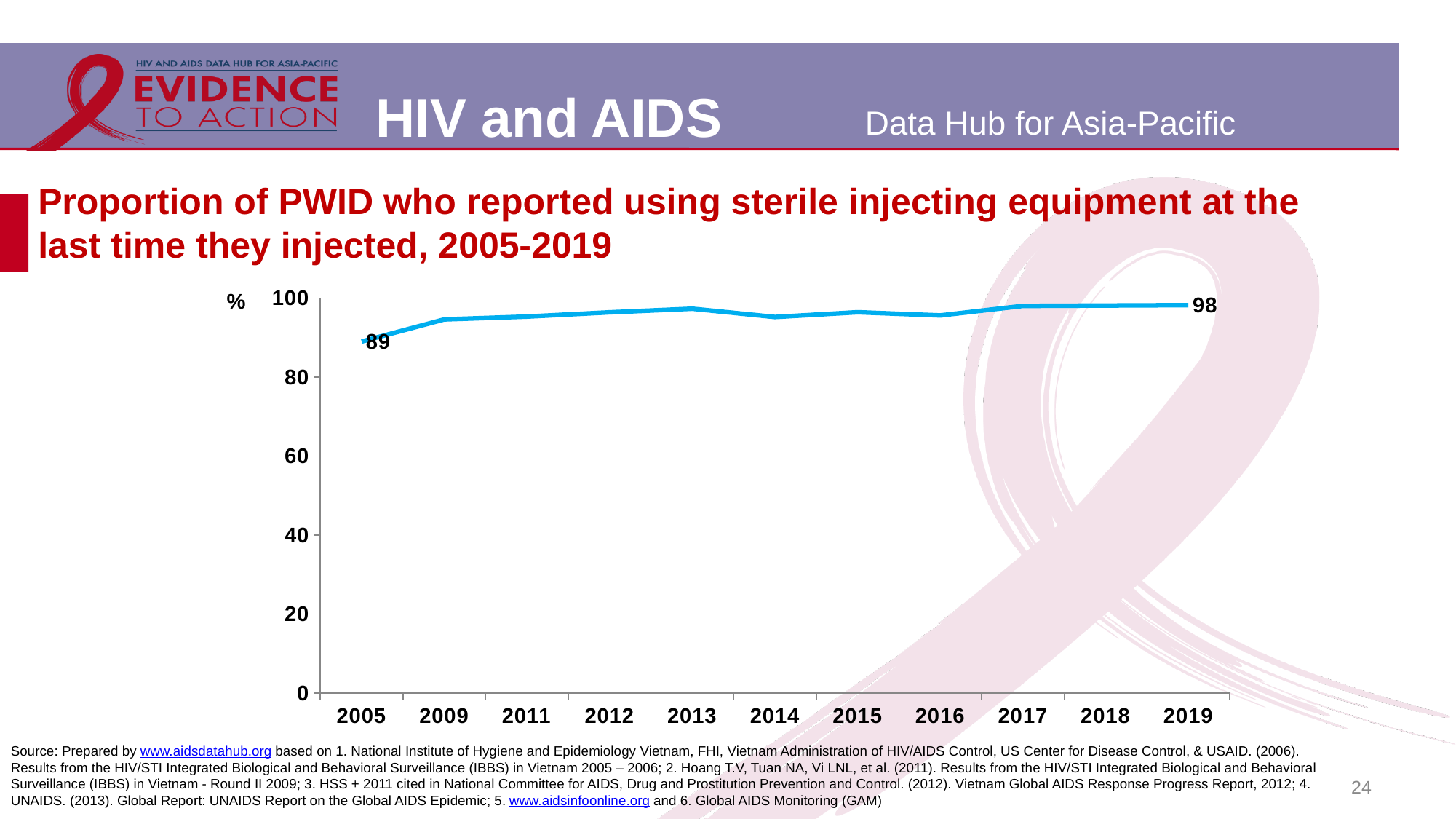
What is the value for 2019? 98 What is the difference between the values for 2019 and 2005? 9 What kind of chart is this? line chart Is the value for 2014 greater or less than 60? greater What is the title of the chart? Proportion of PWID who reported using sterile injecting equipment at the last time they injected, 2005-2019 What unit is shown on the y axis? % How many years are shown on the x axis? 11 Do the values generally rise or fall from 2005 to 2019? rise Is the value for 2013 greater or less than 80? greater Which is larger, the value for 2005 or the value for 2019? 2019 What is the value for 2005? 89 Which year has the lowest value? 2005